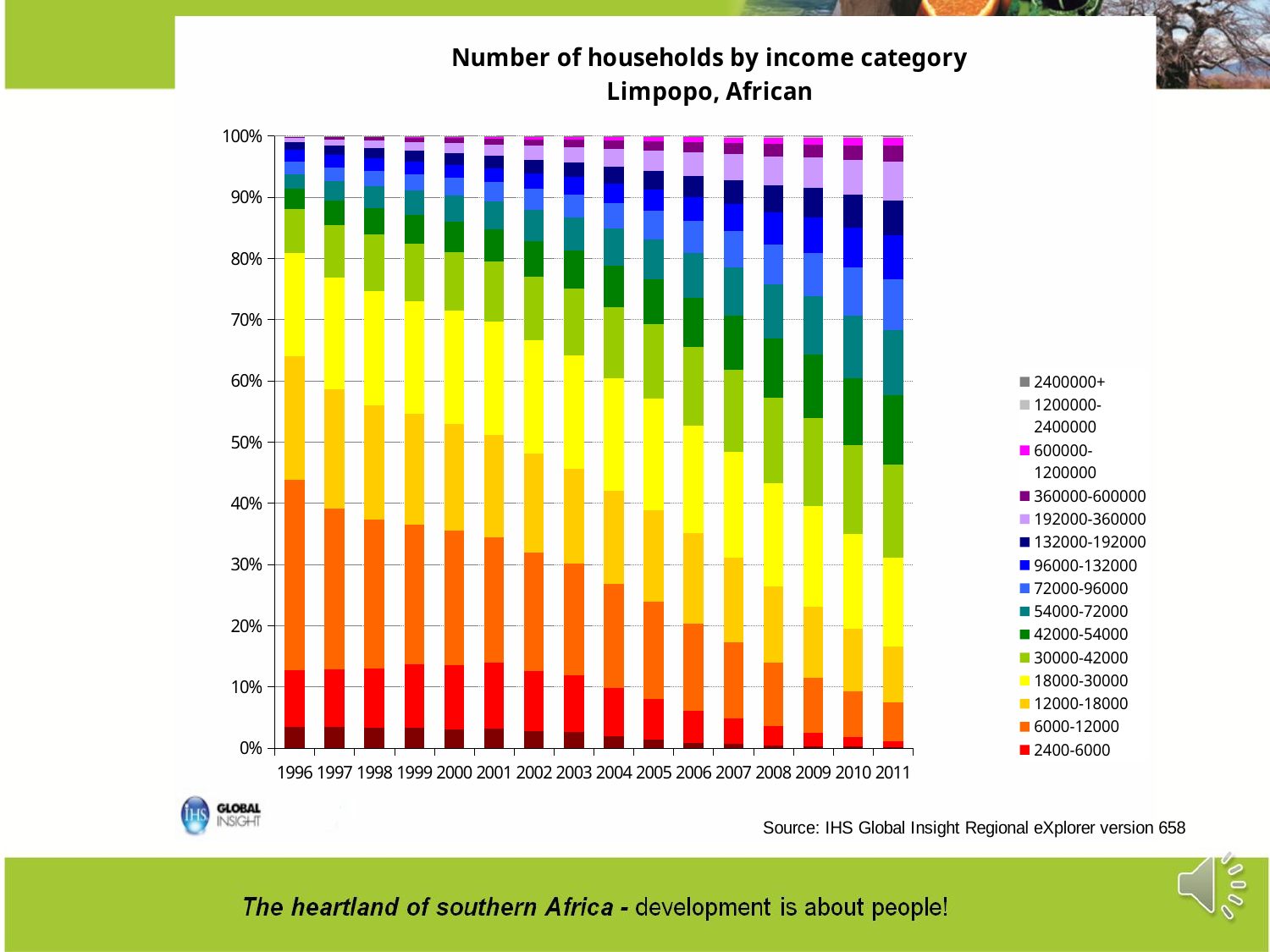
Is the share of the 6000-12000 category in 1996 greater or less than 20%? greater How many years are shown along the x axis? 16 Is the share of the 2400-6000 category in 2011 greater or less than 10%? less What is the title of the chart? Number of households by income category Limpopo, African How many income categories does the legend list? 15 Does the share of the 2400-6000 category rise or fall from 1996 to 2011? fall What is the first year shown on the x axis? 1996 What is the last year shown on the x axis? 2011 What kind of chart is shown on the slide? Stacked bar chart Which year has the larger share for the 6000-12000 category, 1996 or 2011? 1996 What does each stacked bar total? 100%